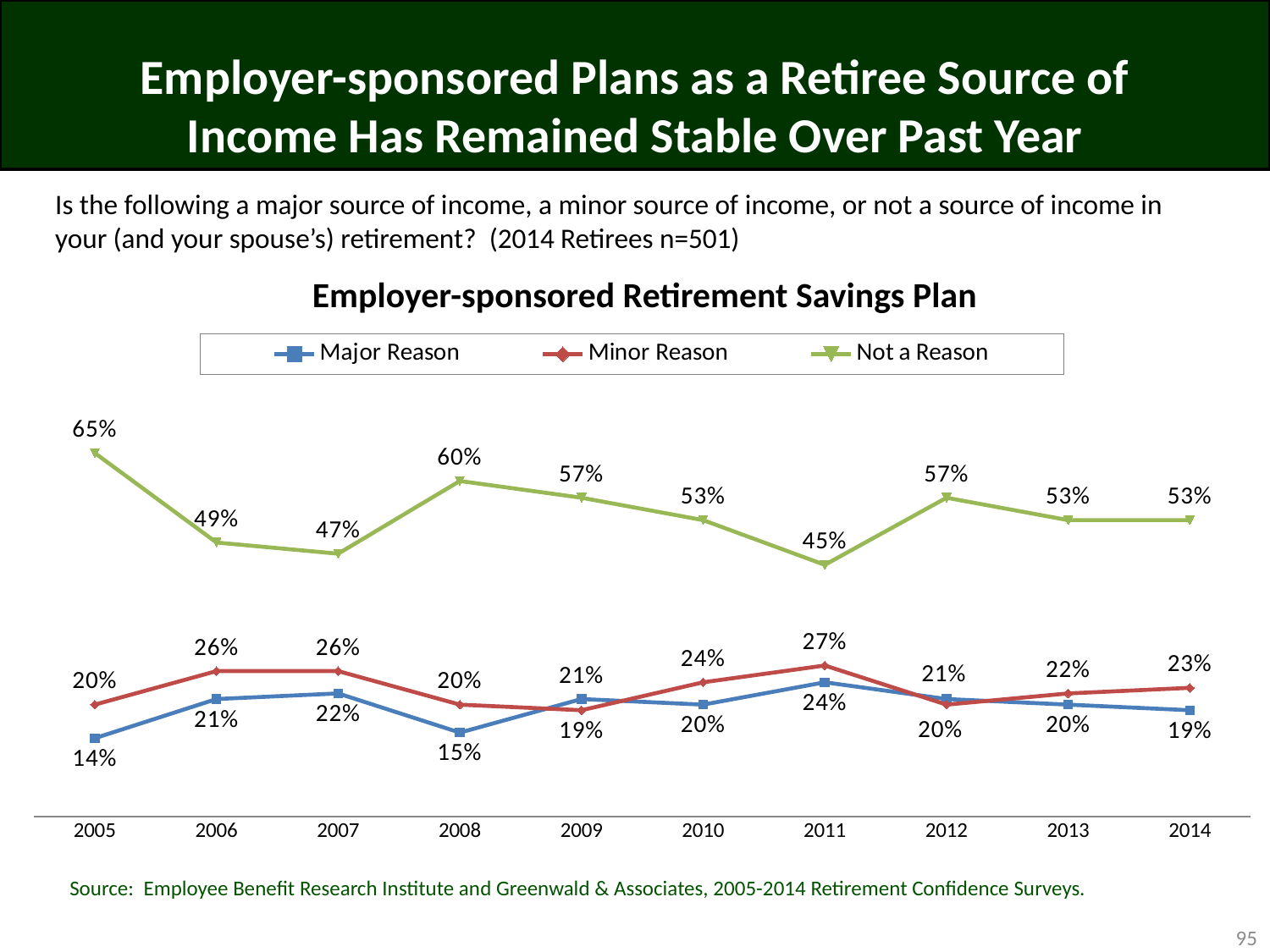
In which year is the Not a Reason series highest? 2005 How many years are plotted along the x axis? 10 What is the value for Major Reason in 2008? 15% In 2006, which is larger: Minor Reason or Major Reason? Minor Reason What is the value for Not a Reason in 2005? 65% By how many percentage points did Not a Reason change from 2005 to 2014? 12 percentage points In which year is the Major Reason series lowest? 2005 In which year is the Not a Reason series lowest? 2011 How many series does the legend list? 3 What kind of chart is shown on the slide? Line chart What is the value for Minor Reason in 2011? 27% What is the title of the chart? Employer-sponsored Retirement Savings Plan